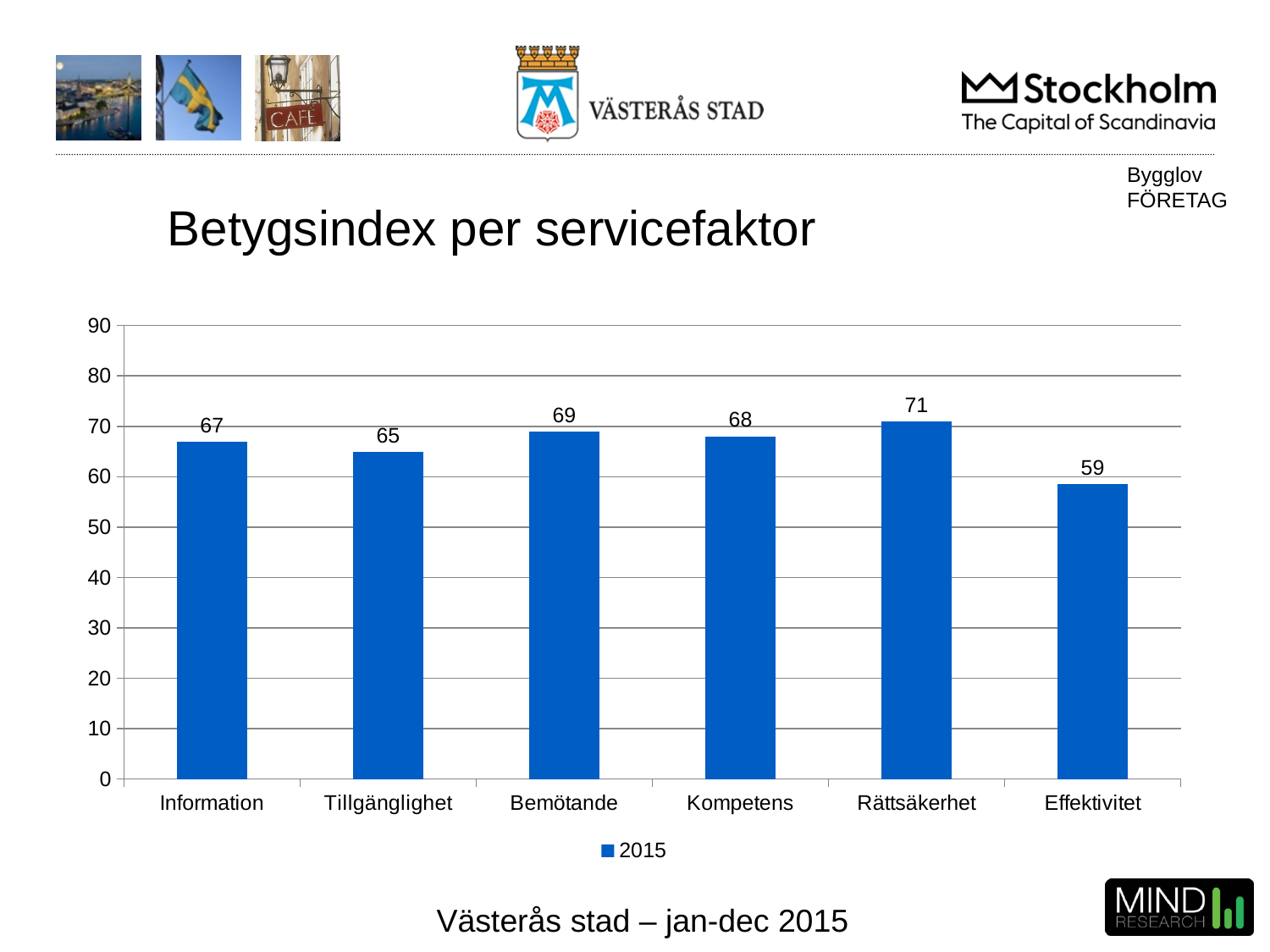
What is the value for Effektivitet? 59 How many series does the legend list? 1 What is the value for Information? 67 What kind of chart is shown? bar chart What is the difference between the values for Rättsäkerhet and Effektivitet? 12 Which category has the highest value? Rättsäkerhet What is the value for Rättsäkerhet? 71 How many categories are shown on the x axis? 6 Is the value for Kompetens greater or less than 60? greater What is the title of the chart? Betygsindex per servicefaktor Which is larger, the value for Bemötande or the value for Tillgänglighet? Bemötande Which category has the lowest value? Effektivitet